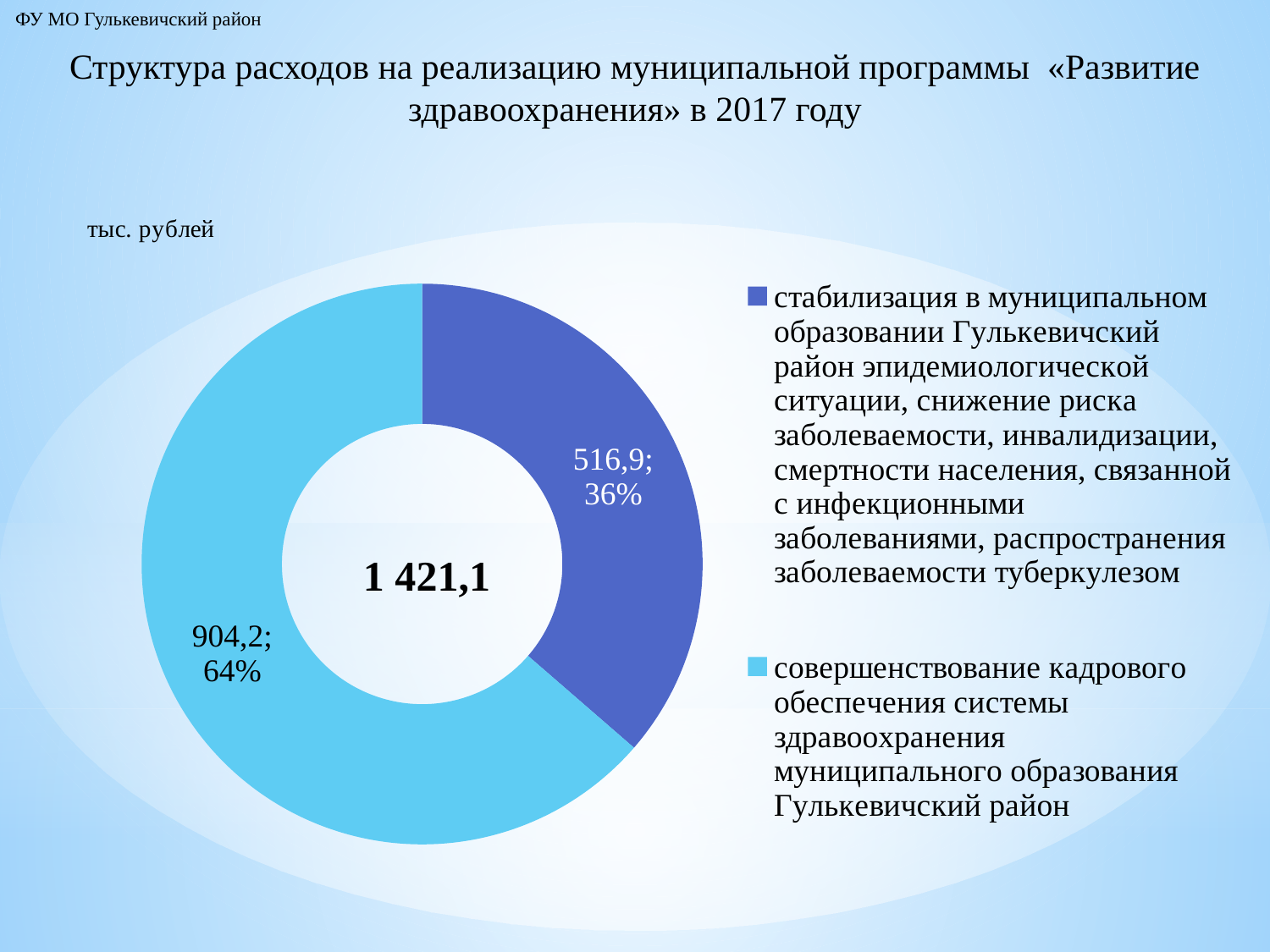
What is the value (тыс. рублей) for «совершенствование кадрового обеспечения системы здравоохранения муниципального образования Гулькевичский район»? 904,2 What share of the total does «совершенствование кадрового обеспечения системы здравоохранения» account for? 64% What share of the total does «стабилизация ... эпидемиологической ситуации» account for? 36% What total is shown in the centre of the chart? 1 421,1 How many categories does the chart show? 2 Which is larger: the value for «совершенствование кадрового обеспечения» or the value for «стабилизация ... эпидемиологической ситуации»? совершенствование кадрового обеспечения In what units are the chart values given? тыс. рублей What is the difference between the two slices, 904,2 and 516,9? 387,3 What is the value (тыс. рублей) for «стабилизация в муниципальном образовании Гулькевичский район эпидемиологической ситуации...»? 516,9 Which category has the largest value? совершенствование кадрового обеспечения системы здравоохранения муниципального образования Гулькевичский район What kind of chart is shown on the slide? doughnut chart